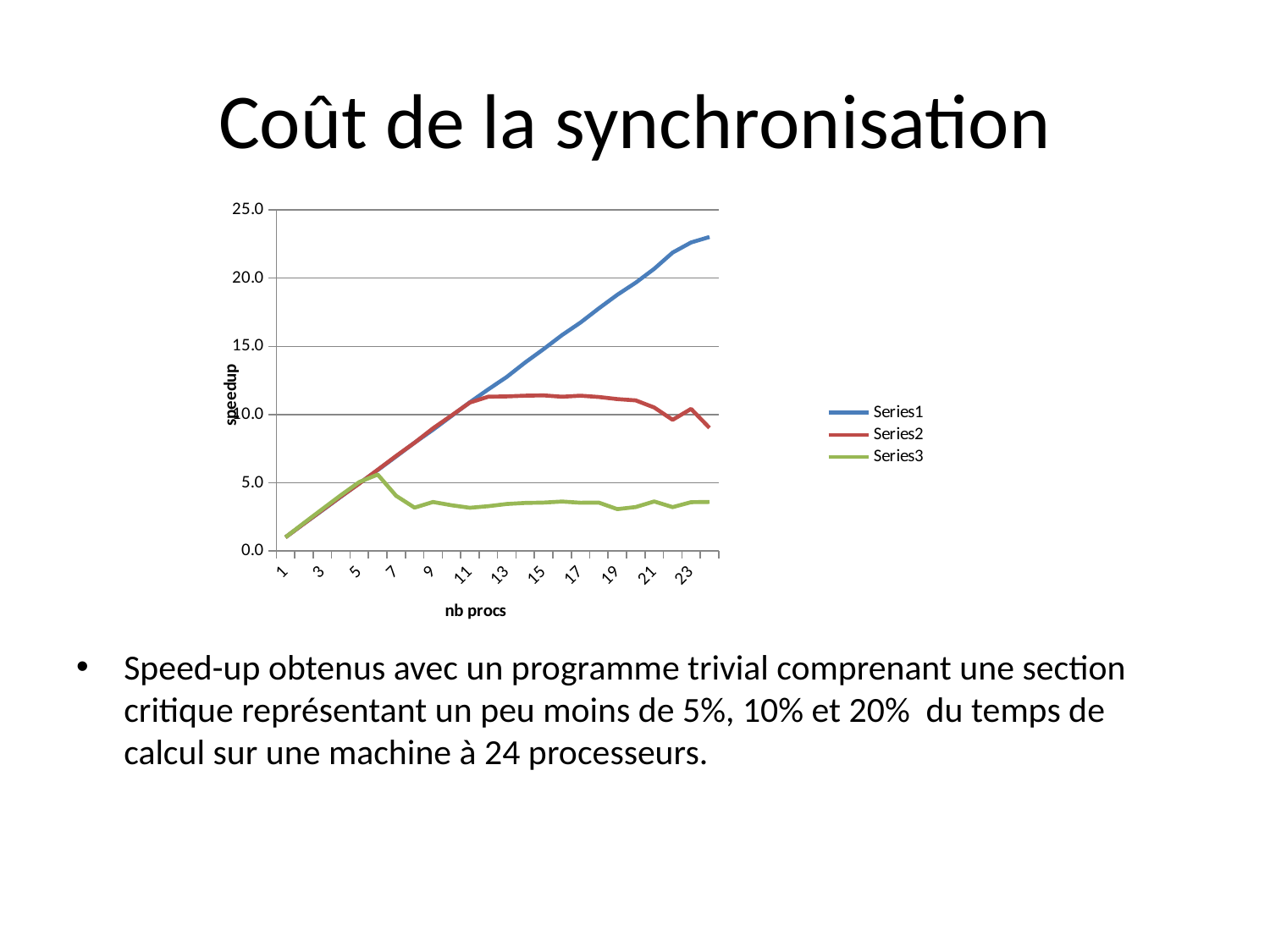
What kind of chart is shown on the slide? line chart Is the value of Series2 at 15 procs greater or less than 10.0? greater At 23 procs, which series has the higher speedup, Series1 or Series2? Series1 Is the value of Series3 at 15 procs greater or less than 5.0? less What is the title of the x axis? nb procs Does Series1 rise or fall as the number of procs increases? rise Is the value of Series1 at 11 procs greater or less than 15.0? less Which series reaches the highest speedup on the chart? Series1 What are the entries in the chart's legend? Series1, Series2, Series3 How many series does the legend list? 3 Which series has the lowest speedup at 23 procs? Series3